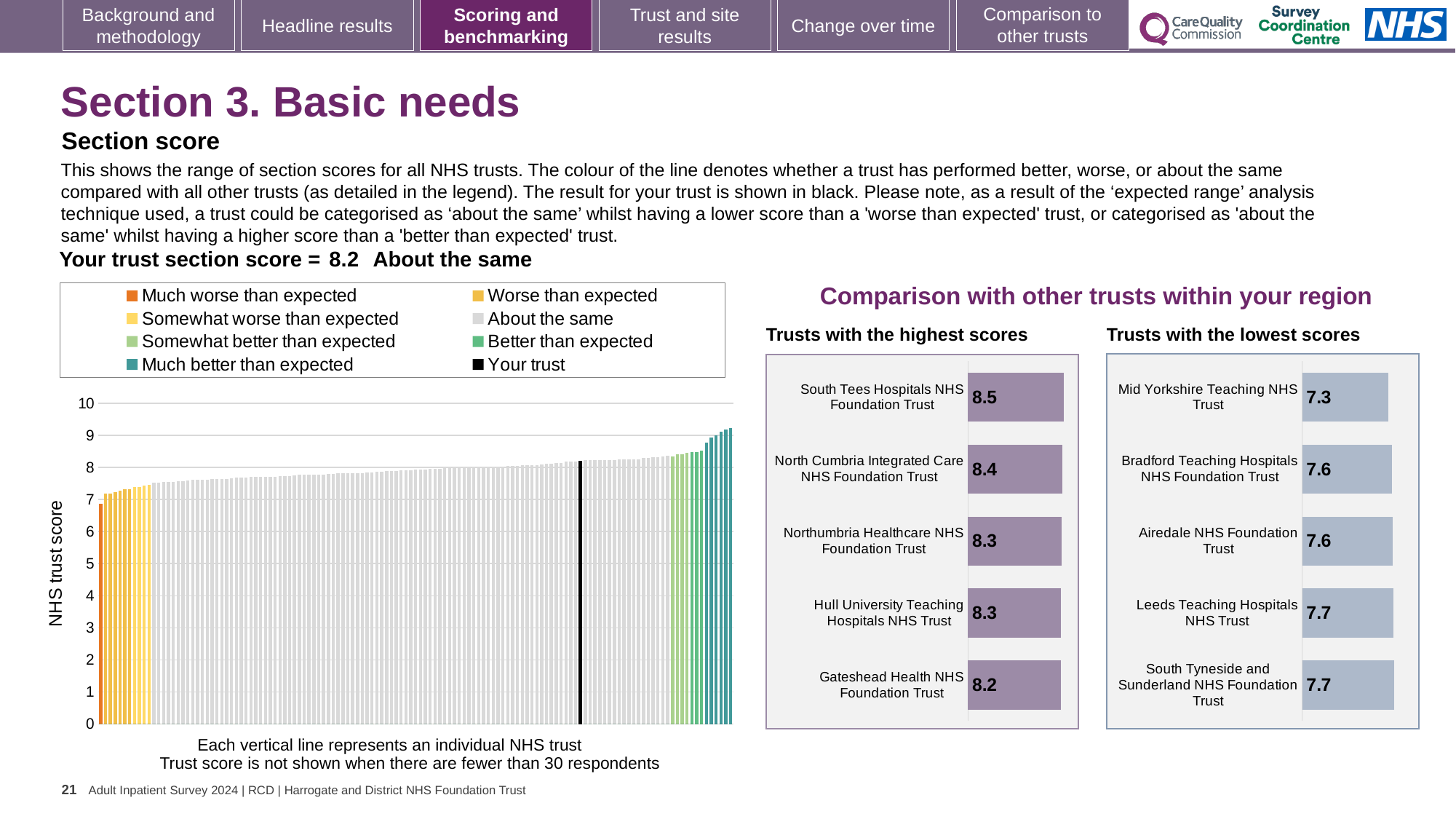
In the 'Trusts with the highest scores' chart, which trust has the highest score? South Tees Hospitals NHS Foundation Trust In the 'Trusts with the lowest scores' chart, which trust has the lowest score? Mid Yorkshire Teaching NHS Trust In the 'Trusts with the highest scores' chart, what is the score for Gateshead Health NHS Foundation Trust? 8.2 How many trusts are listed in the 'Trusts with the highest scores' chart? 5 How many entries does the legend of the large 'NHS trust score' chart on the left list? 8 In the 'Trusts with the highest scores' chart, what is the score for South Tees Hospitals NHS Foundation Trust? 8.5 In the large 'NHS trust score' chart on the left, what is the section score for your trust (the black line)? 8.2 In the 'Trusts with the lowest scores' chart, what is the difference between the scores of Leeds Teaching Hospitals NHS Trust and Mid Yorkshire Teaching NHS Trust? 0.4 In the 'Trusts with the lowest scores' chart, what is the score for Mid Yorkshire Teaching NHS Trust? 7.3 In the 'Trusts with the lowest scores' chart, which has the higher score: Bradford Teaching Hospitals NHS Foundation Trust or Leeds Teaching Hospitals NHS Trust? Leeds Teaching Hospitals NHS Trust In the 'Trusts with the highest scores' chart, what is the difference between the scores of South Tees Hospitals NHS Foundation Trust and Gateshead Health NHS Foundation Trust? 0.3 In the large 'NHS trust score' chart on the left, is the value of the highest bar greater or less than 9? greater